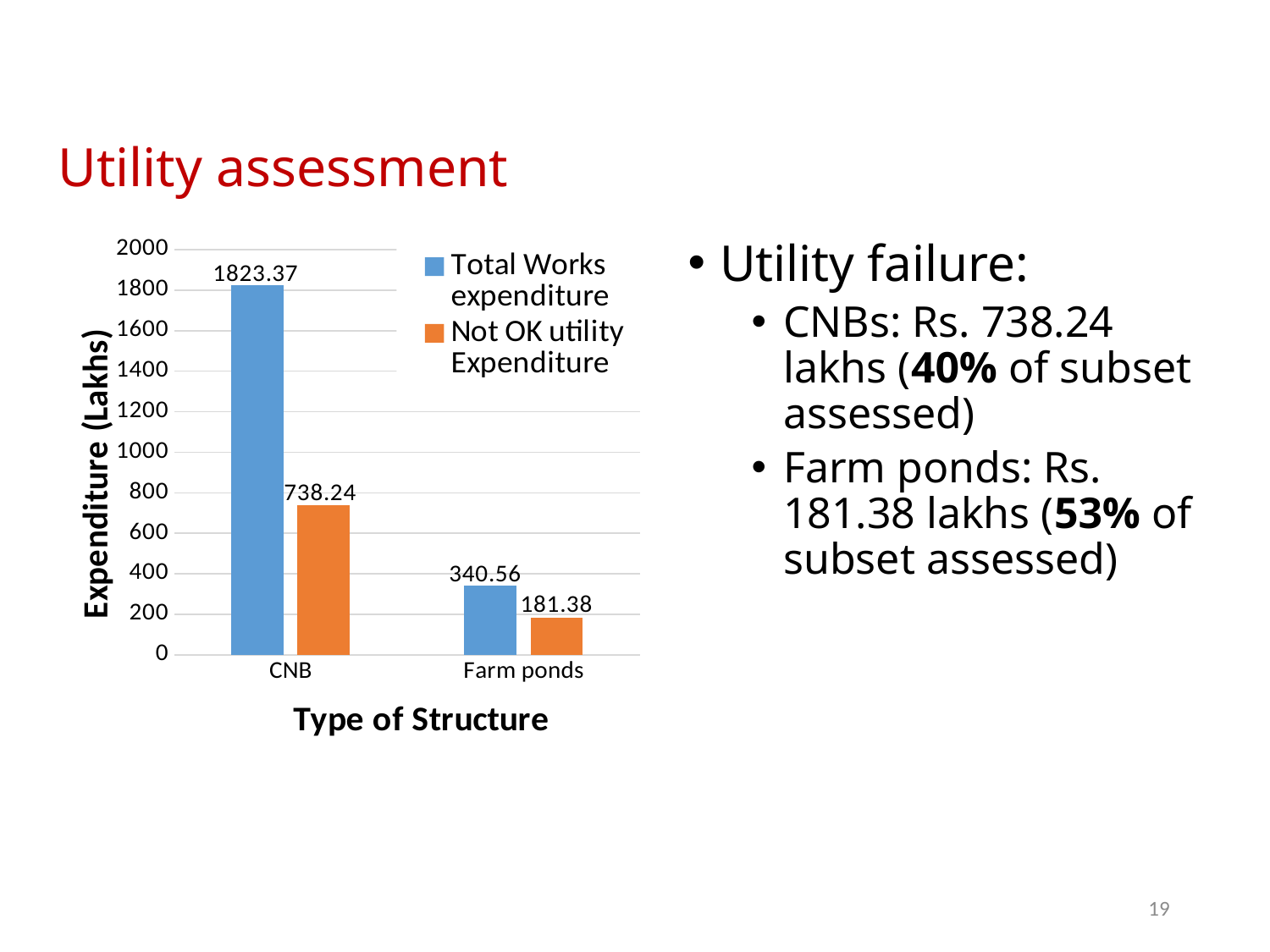
Which is larger: the Not OK utility Expenditure for CNB or the Total Works expenditure for Farm ponds? Not OK utility Expenditure for CNB How many types of structure are shown on the x axis? 2 What kind of chart is shown on the slide? Bar chart Which type of structure has the lowest Not OK utility Expenditure? Farm ponds What is the Not OK utility Expenditure for CNB? 738.24 Which type of structure has the highest Total Works expenditure? CNB What is the Not OK utility Expenditure for Farm ponds? 181.38 How many series does the legend list? 2 What is the difference between the Total Works expenditure and the Not OK utility Expenditure for CNB? 1085.13 What is the label of the y axis? Expenditure (Lakhs) What is the Total Works expenditure for Farm ponds? 340.56 What is the Total Works expenditure for CNB? 1823.37